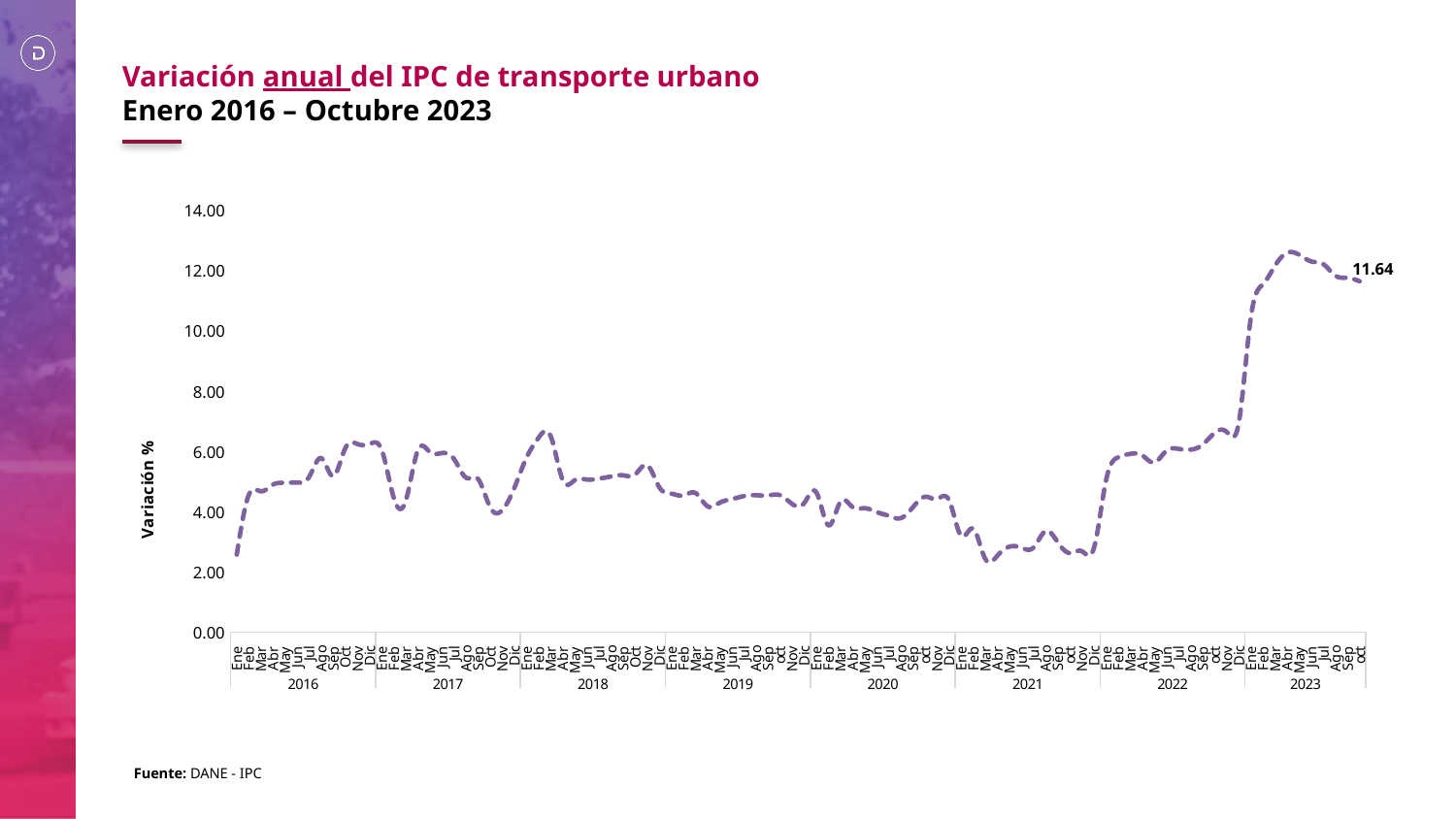
Which is larger, the value for October 2023 or the value for January 2016? October 2023 Does the series rise or fall between December 2022 and April 2023? rises Is the value for January 2016 (the first point) greater or less than 4.00? less What is the title of the vertical axis? Variación % What kind of chart is shown on the slide? line chart Which year on the x axis contains the highest values of the series? 2023 Is the value for March 2021 greater or less than 4.00? less How many years are labelled along the x axis? 8 Is the value for October 2023 greater or less than 10.00? greater What source is cited below the chart? DANE - IPC What is the value of the annual variation for October 2023, the last point on the chart? 11.64